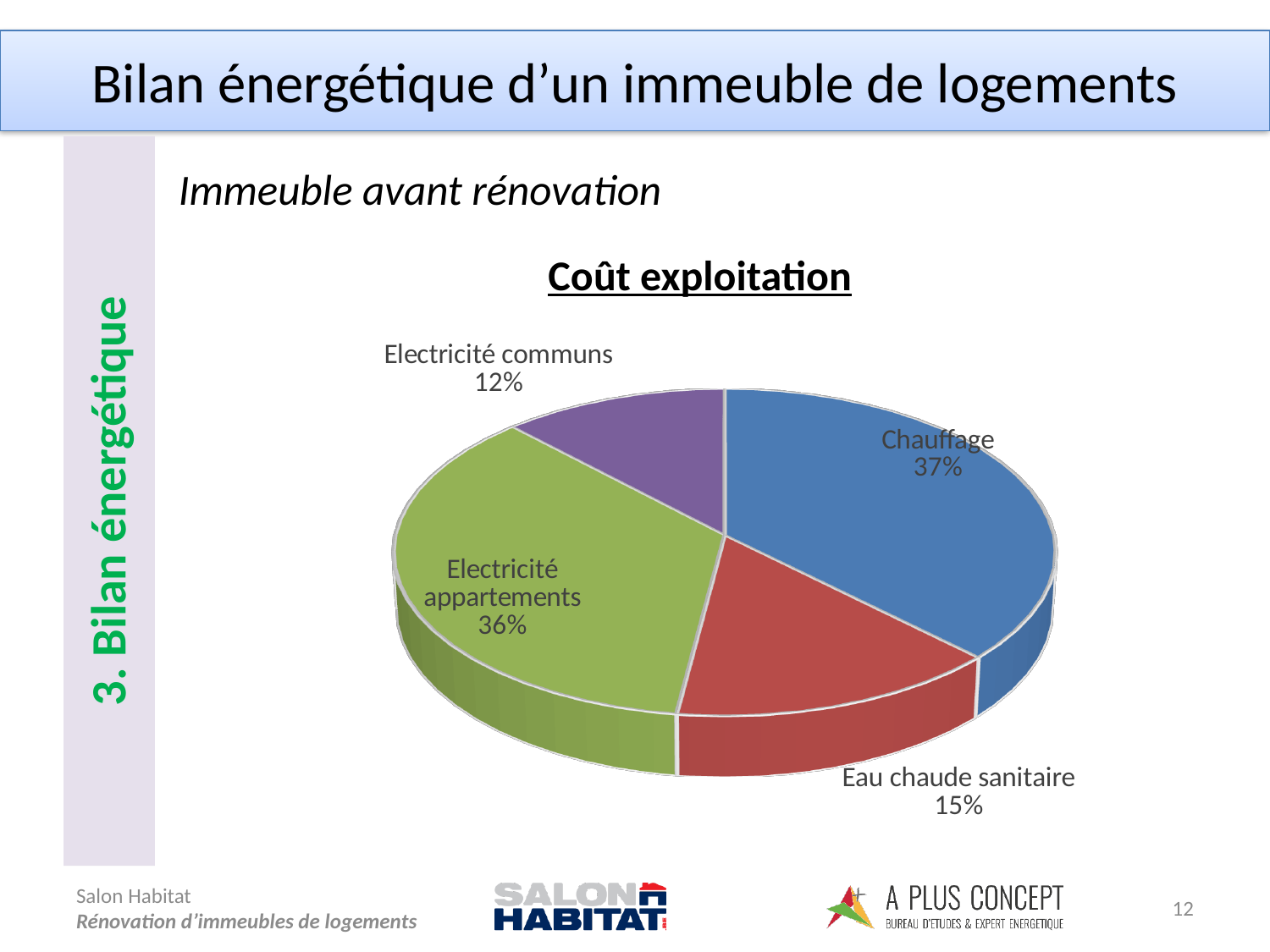
What kind of chart is shown on the slide? Pie chart Which category has the largest share of the operating cost? Chauffage What share of the operating cost is Eau chaude sanitaire? 15% What is the difference in percentage points between Chauffage and Eau chaude sanitaire? 22 What share of the operating cost (Coût exploitation) is Chauffage? 37% Which category has the smallest share of the operating cost? Electricité communs Which is larger: the share for Eau chaude sanitaire or the share for Electricité communs? Eau chaude sanitaire What share of the operating cost is Electricité appartements? 36% What is the title of the chart? Coût exploitation What is the difference in percentage points between Electricité appartements and Electricité communs? 24 How many categories does the pie chart show? 4